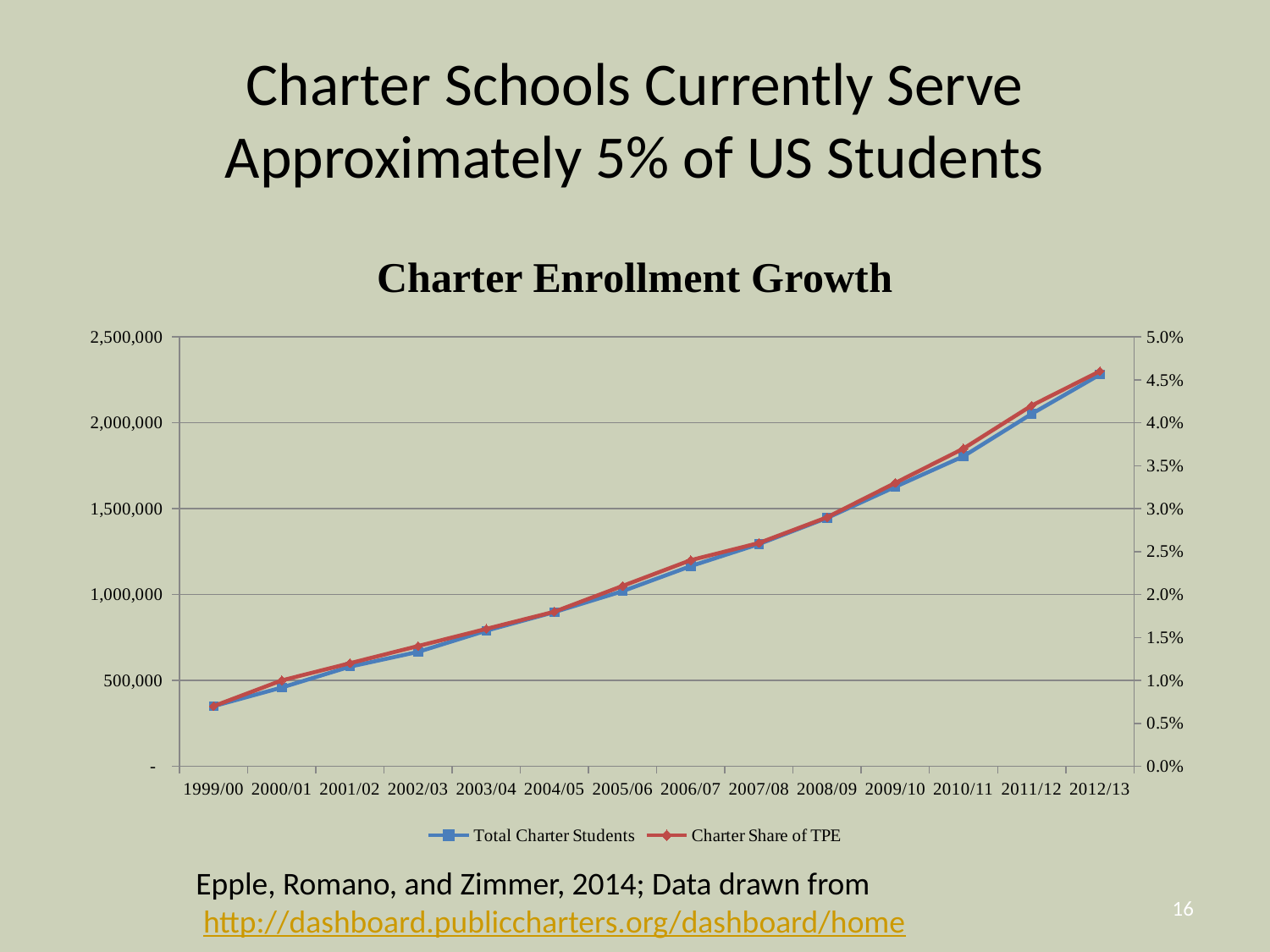
What is the title of the chart? Charter Enrollment Growth What kind of chart is shown on the slide? line chart How many series does the legend list? 2 Is the value for Charter Share of TPE in 2004/05 greater or less than 2.0%? less Is the value for Total Charter Students in 2006/07 greater or less than 1,000,000? greater In which school year is Total Charter Students highest? 2012/13 Is the value for Total Charter Students in 2012/13 greater or less than 2,000,000? greater Do the values for Total Charter Students rise or fall from 1999/00 to 2012/13? rise In which school year is Charter Share of TPE lowest? 1999/00 How many school years are plotted along the x axis? 14